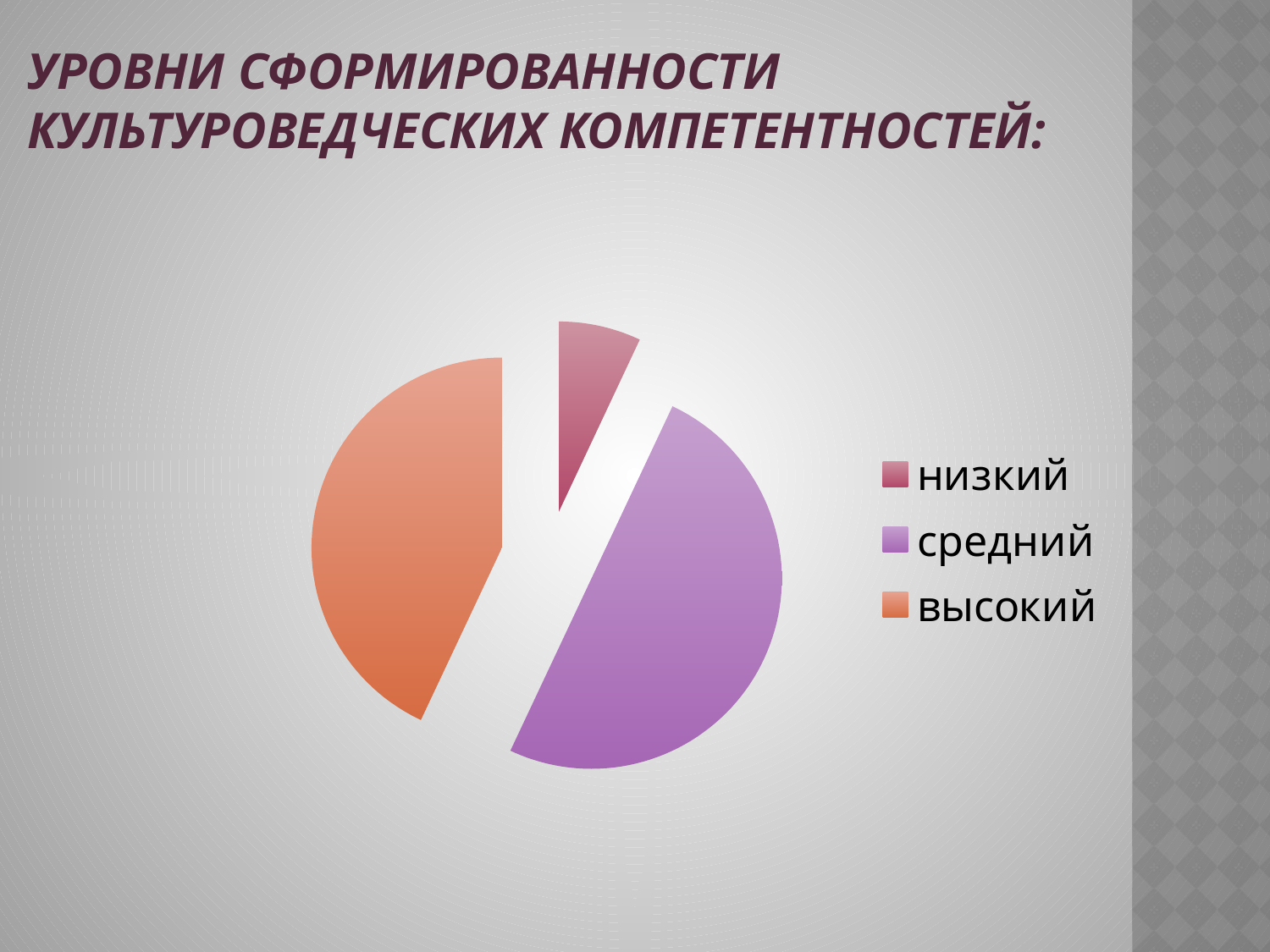
Which category has the smallest slice of the pie? низкий What colour is the slice for высокий? orange Which slice is larger, средний or низкий? средний What is the title of the slide above the chart? УРОВНИ СФОРМИРОВАННОСТИ КУЛЬТУРОВЕДЧЕСКИХ КОМПЕТЕНТНОСТЕЙ: Which slice is larger, средний or высокий? средний How many entries does the legend list? 3 What kind of chart is shown on the slide? pie chart How many slices does the pie chart have? 3 Which category has the largest slice of the pie? средний Which slice is larger, высокий or низкий? высокий